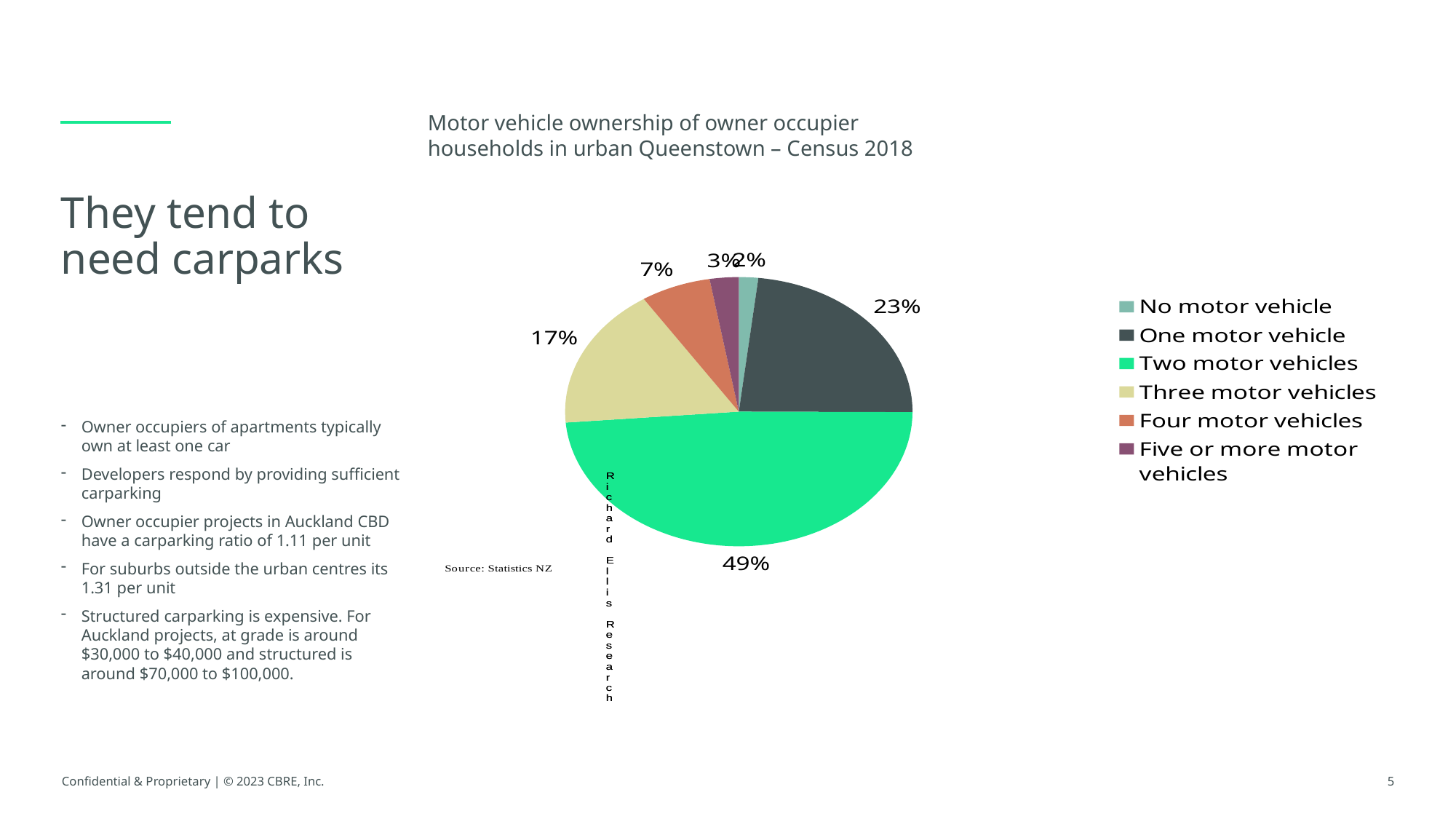
Which category has the largest share of the pie? Two motor vehicles What is the difference in percentage points between the two motor vehicles share and the one motor vehicle share? 26 percentage points What share of households have four motor vehicles? 7% Which is larger: the share for three motor vehicles or the share for four motor vehicles? Three motor vehicles What is the title of the chart? Motor vehicle ownership of owner occupier households in urban Queenstown – Census 2018 Which category has the smallest share of the pie? No motor vehicle What share of households have one motor vehicle? 23% What share of households have three motor vehicles? 17% What kind of chart is shown on the slide? Pie chart What source is cited for the chart data? Statistics NZ What share of owner occupier households in urban Queenstown have two motor vehicles? 49% How many categories does the legend list? 6